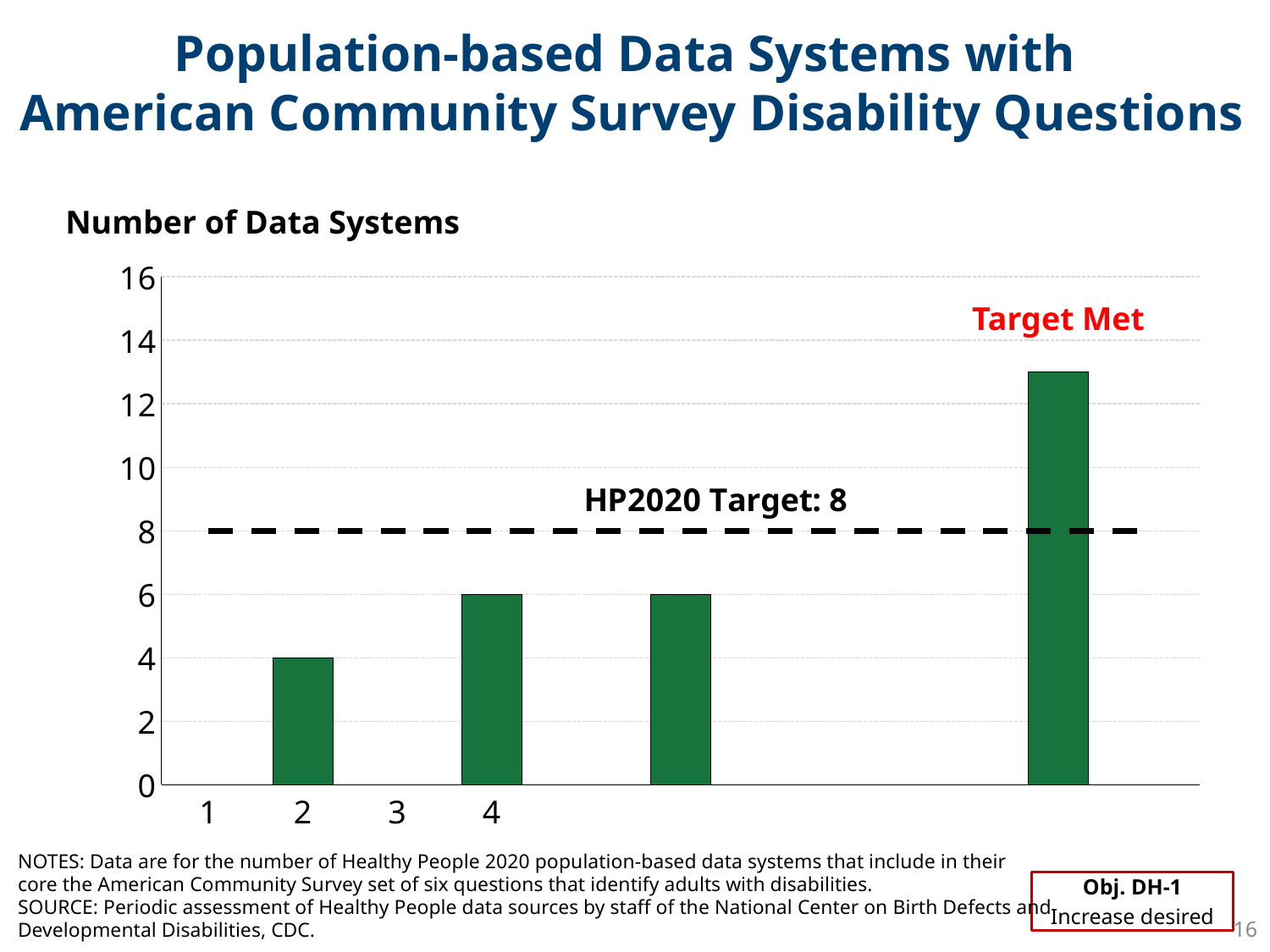
What label is written above the rightmost bar in red? Target Met What is the difference between the value for category 4 and the value for category 2? 2 What kind of chart is shown on the slide? bar chart Which is larger, the value for category 2 or the value for category 4? category 4 Is the value of the rightmost bar greater or less than 12? greater What is the HP2020 target value shown by the dashed line? 8 Which category has the lowest bar in the chart? 2 How many bars are plotted in the chart? 4 What is the number of data systems for category 2? 4 Which bar is the highest in the chart? the rightmost bar Is the value for category 2 greater or less than the HP2020 target of 8? less What is the number of data systems for category 4? 6